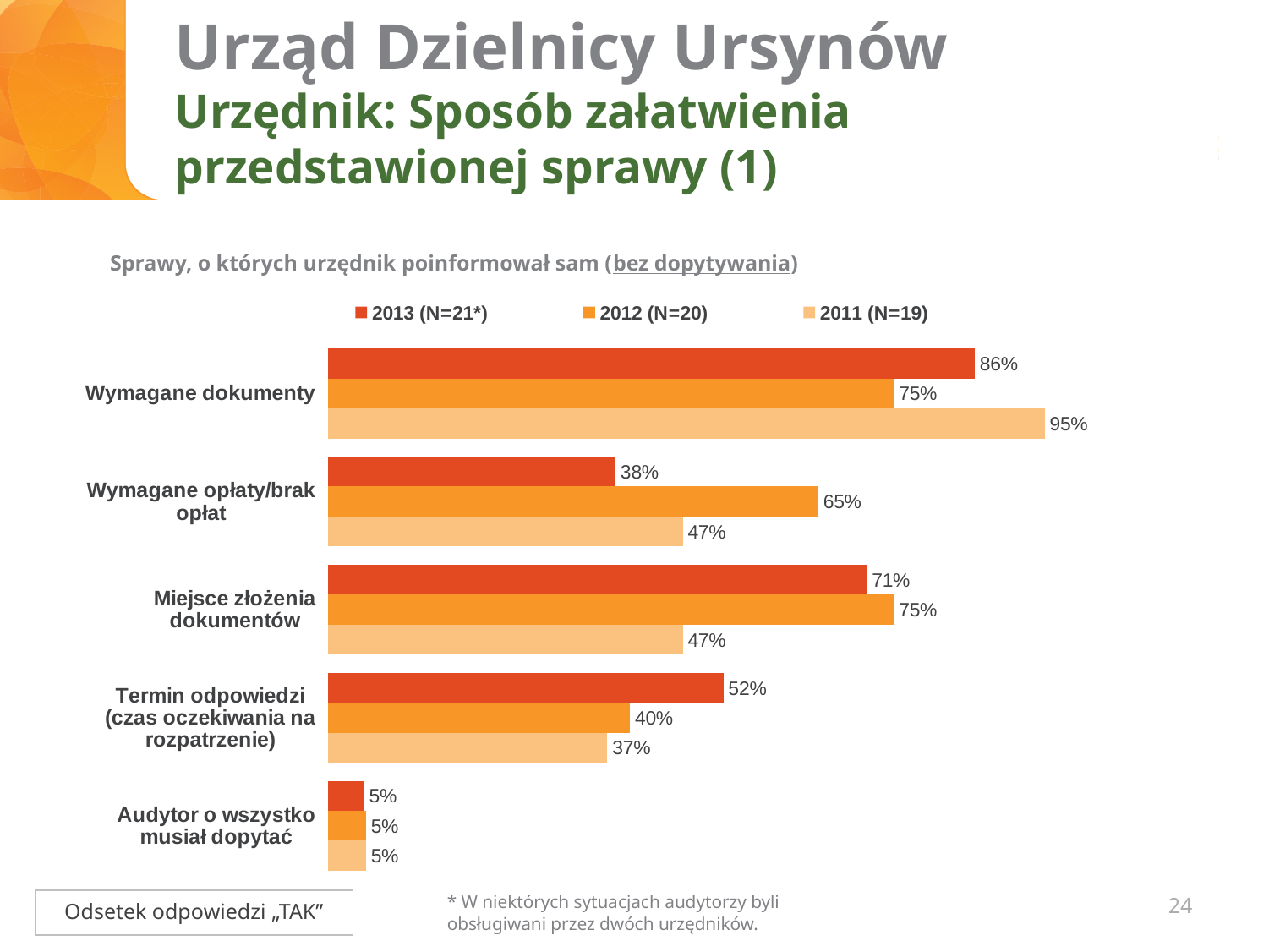
What is the value for Wymagane opłaty/brak opłat in the 2012 (N=20) series? 65% What kind of chart is shown on the slide? Bar chart What is the difference between the 2011 (N=19) and 2012 (N=20) values for Wymagane dokumenty? 20% Which category has the highest value in the 2011 (N=19) series? Wymagane dokumenty Which is larger for Miejsce złożenia dokumentów: the 2013 (N=21*) value or the 2011 (N=19) value? 2013 (N=21*) What is the value for Wymagane dokumenty in the 2013 (N=21*) series? 86% What is the difference between the 2013 (N=21*) and 2012 (N=20) values for Termin odpowiedzi (czas oczekiwania na rozpatrzenie)? 12% What is the subtitle text shown above the chart legend? Sprawy, o których urzędnik poinformował sam (bez dopytywania) How many categories are shown on the chart? 5 Which category has the lowest value in the 2013 (N=21*) series? Audytor o wszystko musiał dopytać How many series does the legend list? 3 What is the value for Termin odpowiedzi (czas oczekiwania na rozpatrzenie) in the 2011 (N=19) series? 37%